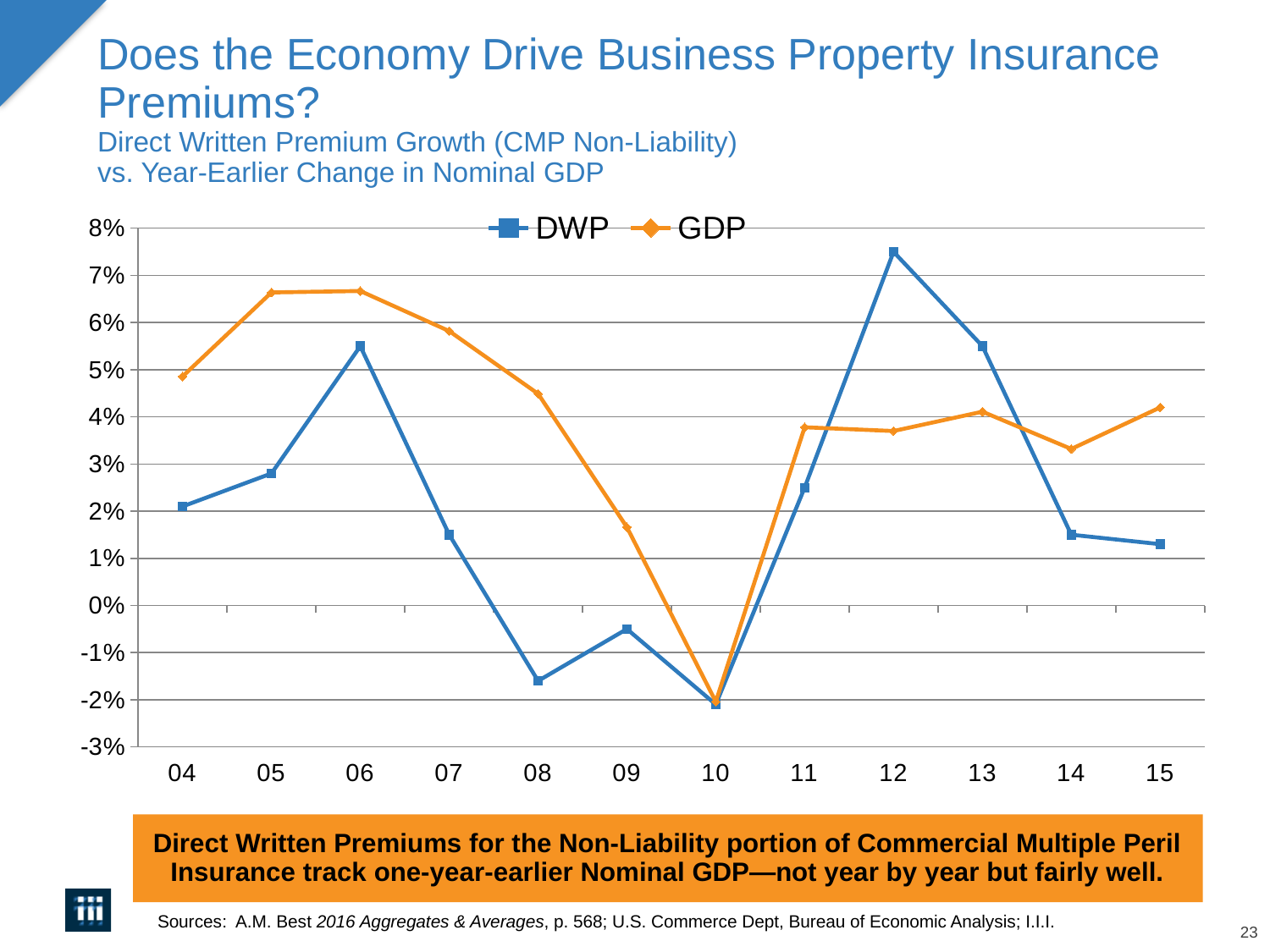
In 12, which series has the larger value, DWP or GDP? DWP How many series does the legend list? 2 Does the GDP series rise or fall from 06 to 10? fall Is the DWP value for 12 greater or less than 7%? greater In 07, which series has the larger value, DWP or GDP? GDP What kind of chart is shown on the slide? line chart In which year does the DWP series reach its highest value? 12 Is the DWP value for 08 greater or less than -1%? less In which year does the DWP series reach its lowest value? 10 In which year does the GDP series reach its lowest value? 10 How many years are plotted along the x axis? 12